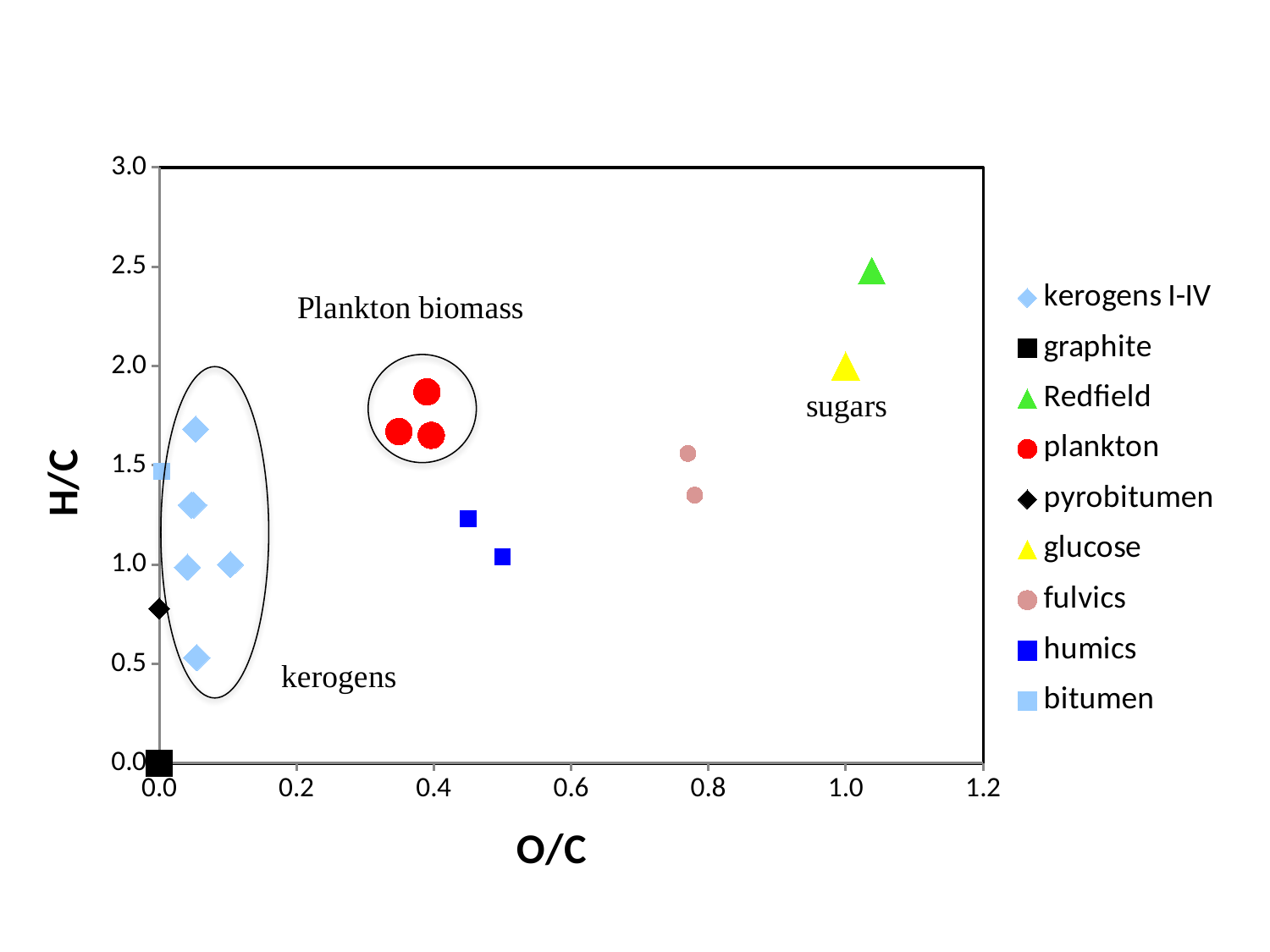
Which has a higher H/C value, the plankton points or the humics points? plankton Are the O/C values for the fulvics points greater or less than 0.6? greater How many plankton points are plotted inside the 'Plankton biomass' circle? 3 Which series has the lowest H/C value? graphite What is the label of the y axis? H/C Is the H/C value for Redfield greater or less than 2.0? greater Which series has the highest H/C value? Redfield What kind of chart is shown on the slide? scatter chart How many series does the legend list? 9 What is the H/C value of the graphite point? 0.0 What is the label of the x axis? O/C